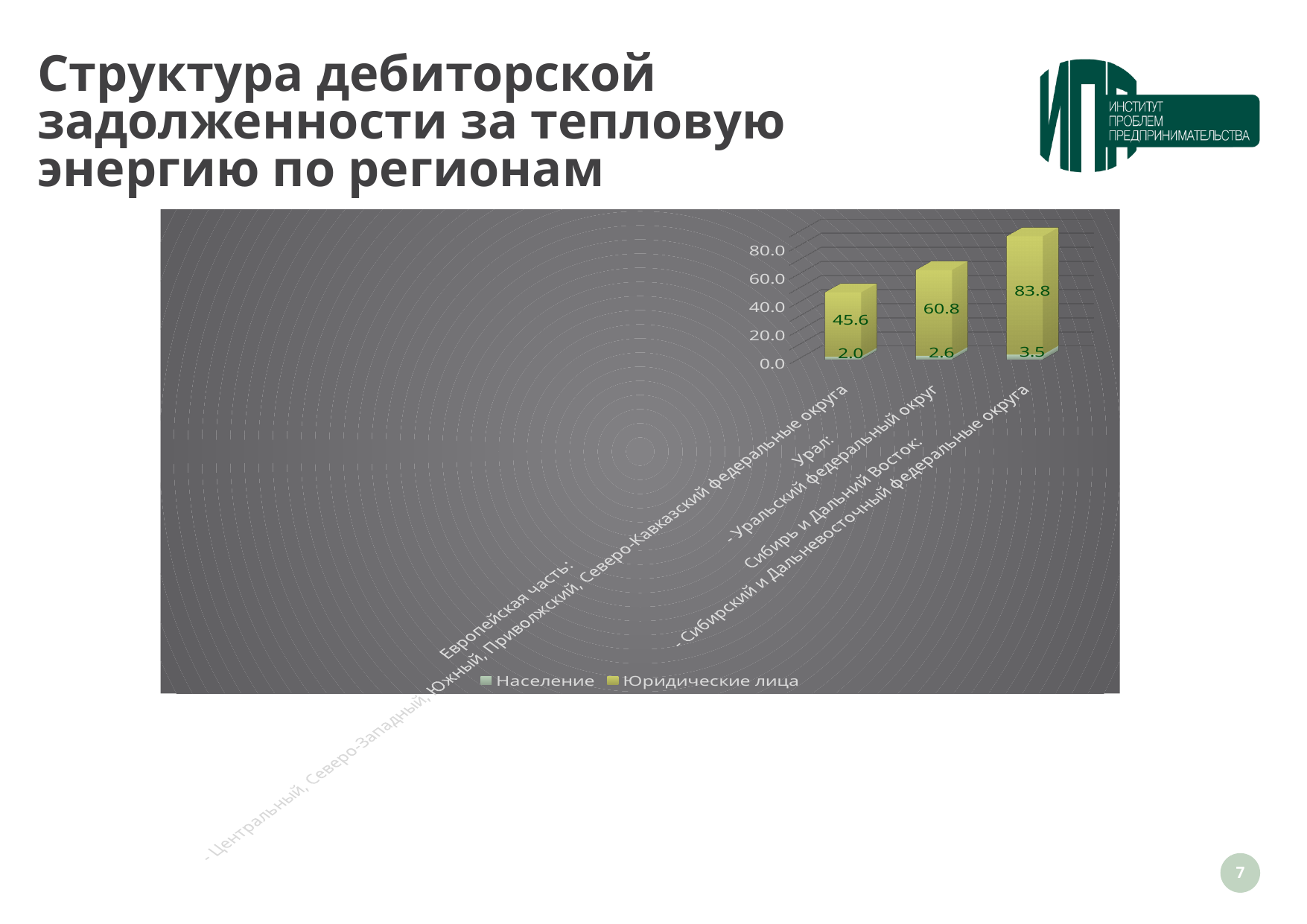
Which region has the lowest value for Население? Европейская часть What is the value of Население for Сибирь и Дальний Восток? 3.5 What is the value of Юридические лица for Европейская часть? 45.6 What kind of chart is shown on the slide? Stacked bar chart How many region categories are plotted on the chart? 3 Which region has the highest value for Юридические лица? Сибирь и Дальний Восток Which series is shown in yellow in the legend? Юридические лица How many series does the legend list? 2 What is the total of the stacked bar for Урал? 63.4 What is the difference between the Юридические лица values for Сибирь и Дальний Восток and Урал? 23.0 What is the value of Население for Европейская часть? 2.0 What is the value of Юридические лица for Урал? 60.8